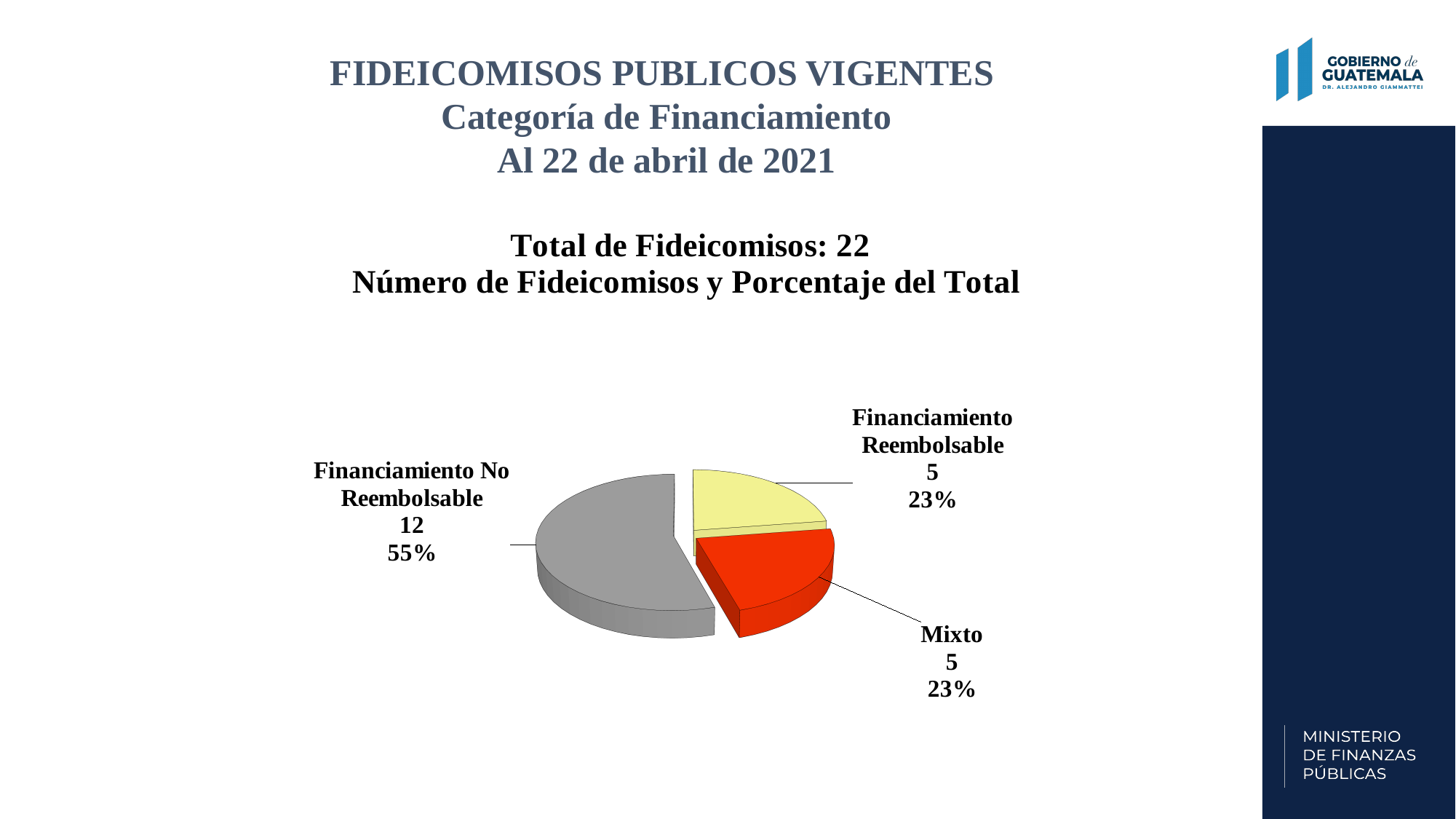
Which is larger, the number of fideicomisos for Financiamiento No Reembolsable or for Financiamiento Reembolsable? Financiamiento No Reembolsable What is the difference in the number of fideicomisos between Financiamiento No Reembolsable and Mixto? 7 What is the total number of fideicomisos stated on the slide? 22 What percentage of the total does Financiamiento No Reembolsable represent? 55% How many fideicomisos are in the Financiamiento Reembolsable category? 5 How many fideicomisos are in the Mixto category? 5 How many fideicomisos are in the Financiamiento No Reembolsable category? 12 What colour is the slice for Financiamiento No Reembolsable? gray What kind of chart is shown on the slide? pie chart What percentage of the total does Mixto represent? 23% Which category has the largest number of fideicomisos? Financiamiento No Reembolsable How many categories does the pie chart show? 3